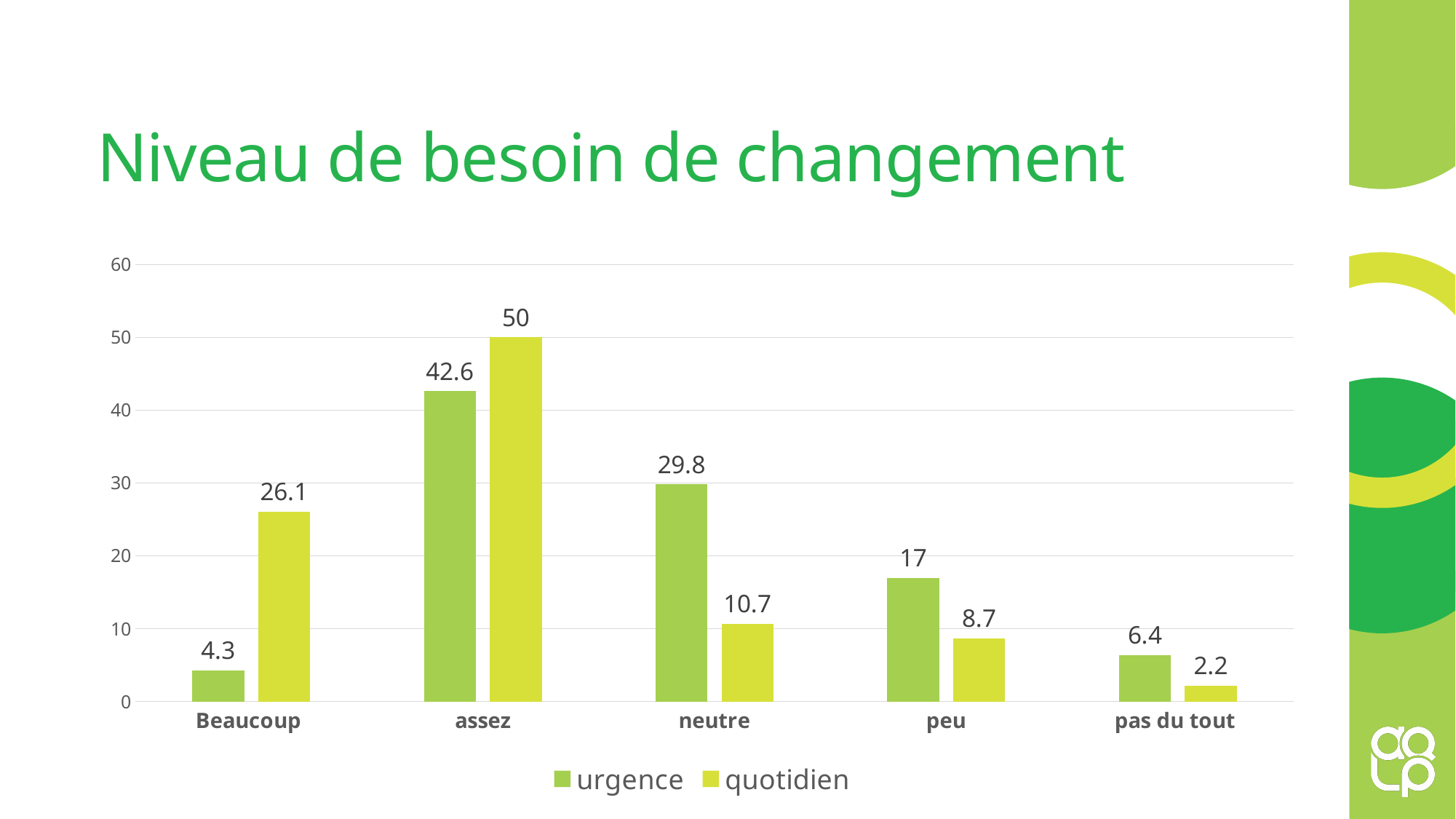
What is the title of the slide? Niveau de besoin de changement Which is larger in the 'peu' category, 'urgence' or 'quotidien'? urgence What kind of chart is shown on the slide? bar chart How many categories are shown on the x axis? 5 Which category has the highest 'quotidien' value? assez Is the 'urgence' value for 'neutre' greater or less than 20? greater How many series does the legend list? 2 Which category has the lowest 'urgence' value? Beaucoup What is the value for 'urgence' in the 'assez' category? 42.6 What is the difference between the 'quotidien' and 'urgence' values in the 'neutre' category? 19.1 What is the value for 'urgence' in the 'pas du tout' category? 6.4 What is the value for 'quotidien' in the 'Beaucoup' category? 26.1